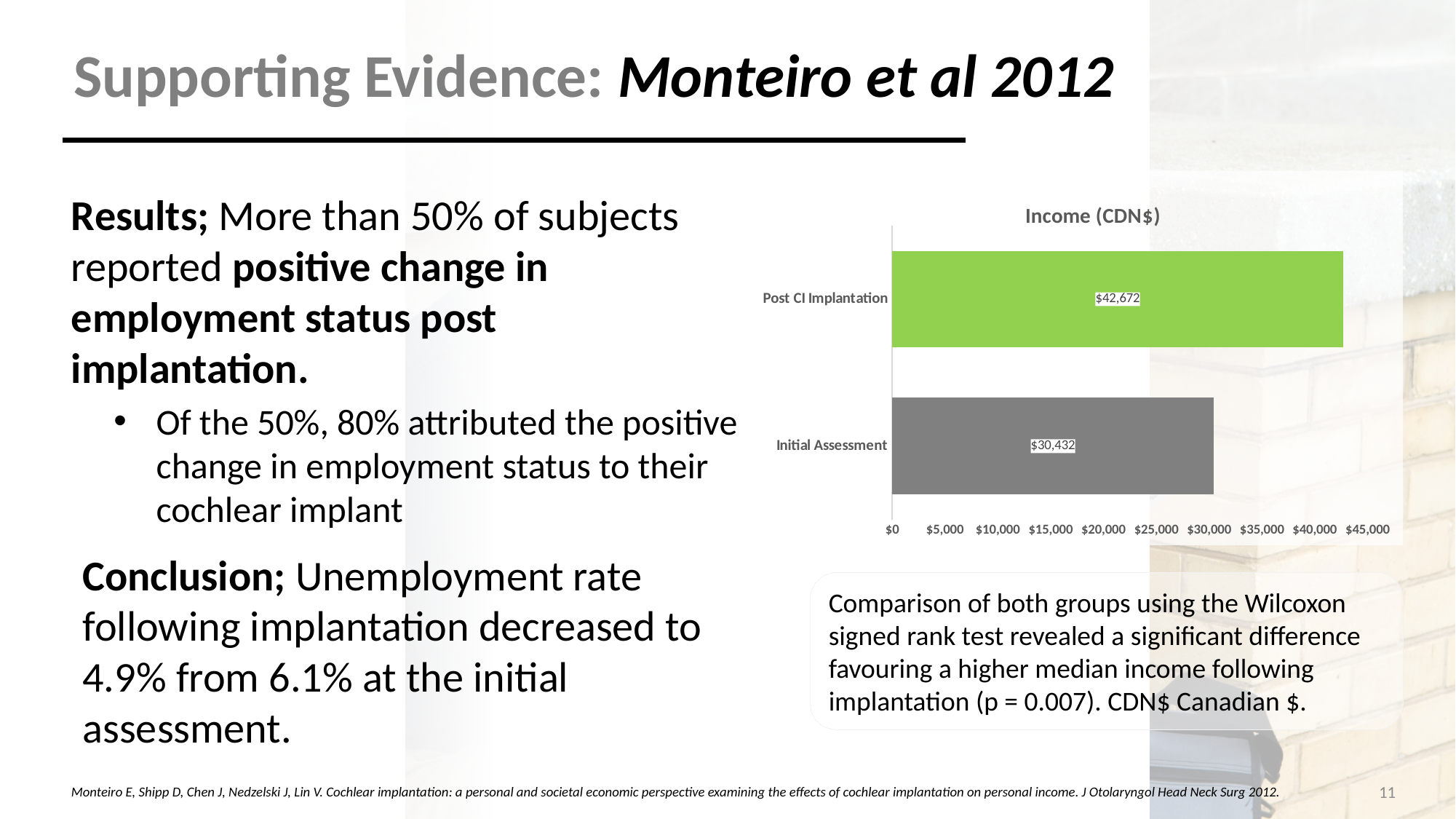
What colour is the bar for Post CI Implantation? green What is the difference in income between Post CI Implantation and Initial Assessment? $12,240 Is the income for Post CI Implantation larger or smaller than for Initial Assessment? larger Which category has the lower income? Initial Assessment How many categories are shown in the chart? 2 Is the income for Post CI Implantation greater or less than $40,000? greater What kind of chart is shown on the slide? bar chart Which category has the higher income? Post CI Implantation What is the title of the chart? Income (CDN$) What is the income value for Post CI Implantation? $42,672 Is the income for Initial Assessment greater or less than $35,000? less What is the income value for Initial Assessment? $30,432